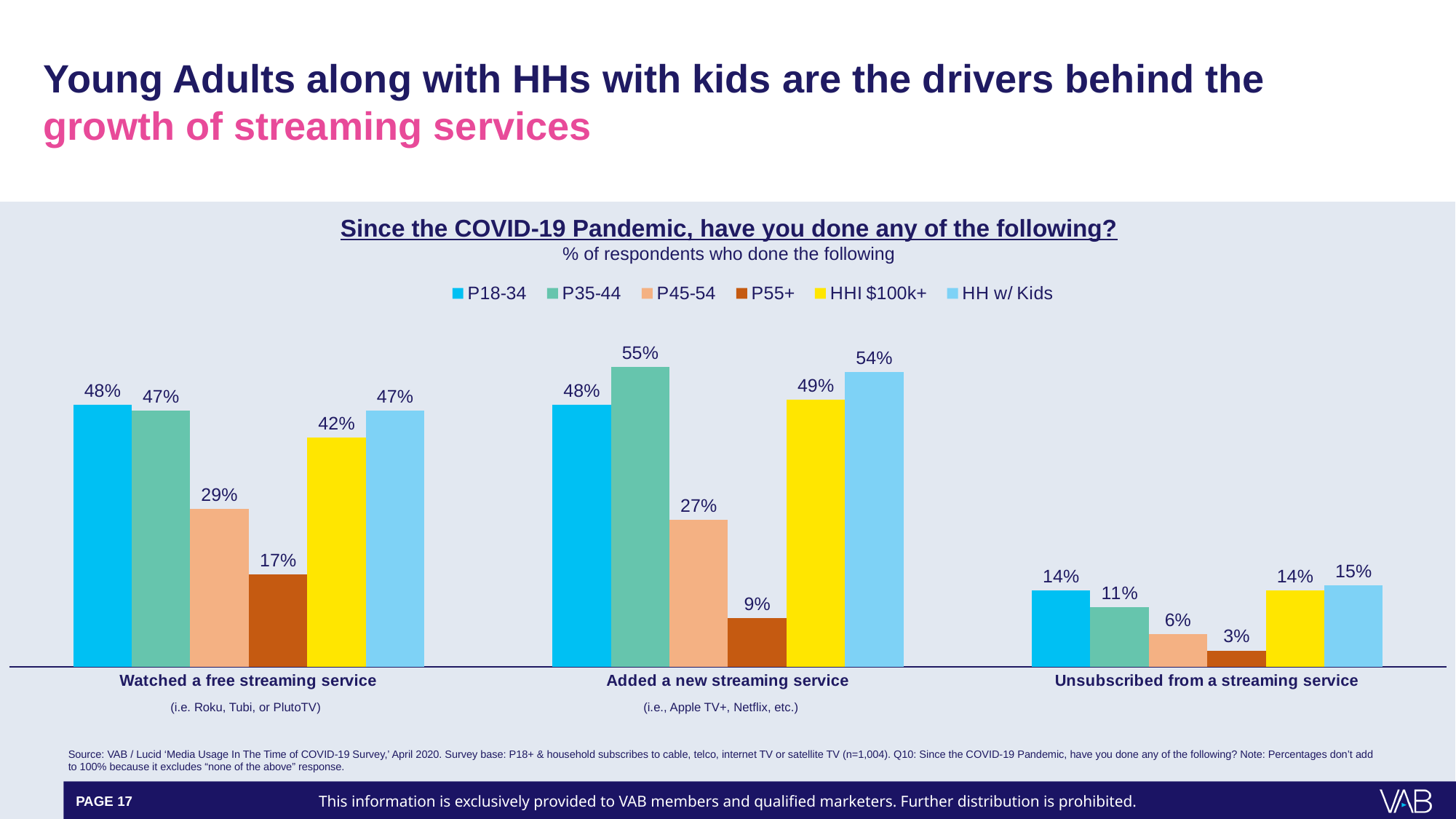
What is the difference between the HH w/ Kids and P55+ values for 'Added a new streaming service'? 45% Which group has the highest value for 'Added a new streaming service'? P35-44 What kind of chart is shown on the slide? Bar chart What percentage of P55+ respondents unsubscribed from a streaming service? 3% What is the difference between the P18-34 and P45-54 values for 'Watched a free streaming service'? 19% What percentage of HHI $100k+ respondents watched a free streaming service? 42% Which is larger for 'Unsubscribed from a streaming service': P18-34 or P35-44? P18-34 How many series does the legend list? 6 Which group has the lowest value for 'Watched a free streaming service'? P55+ What is the title of the chart? Since the COVID-19 Pandemic, have you done any of the following? How many categories are shown on the x axis? 3 What percentage of P35-44 respondents added a new streaming service? 55%